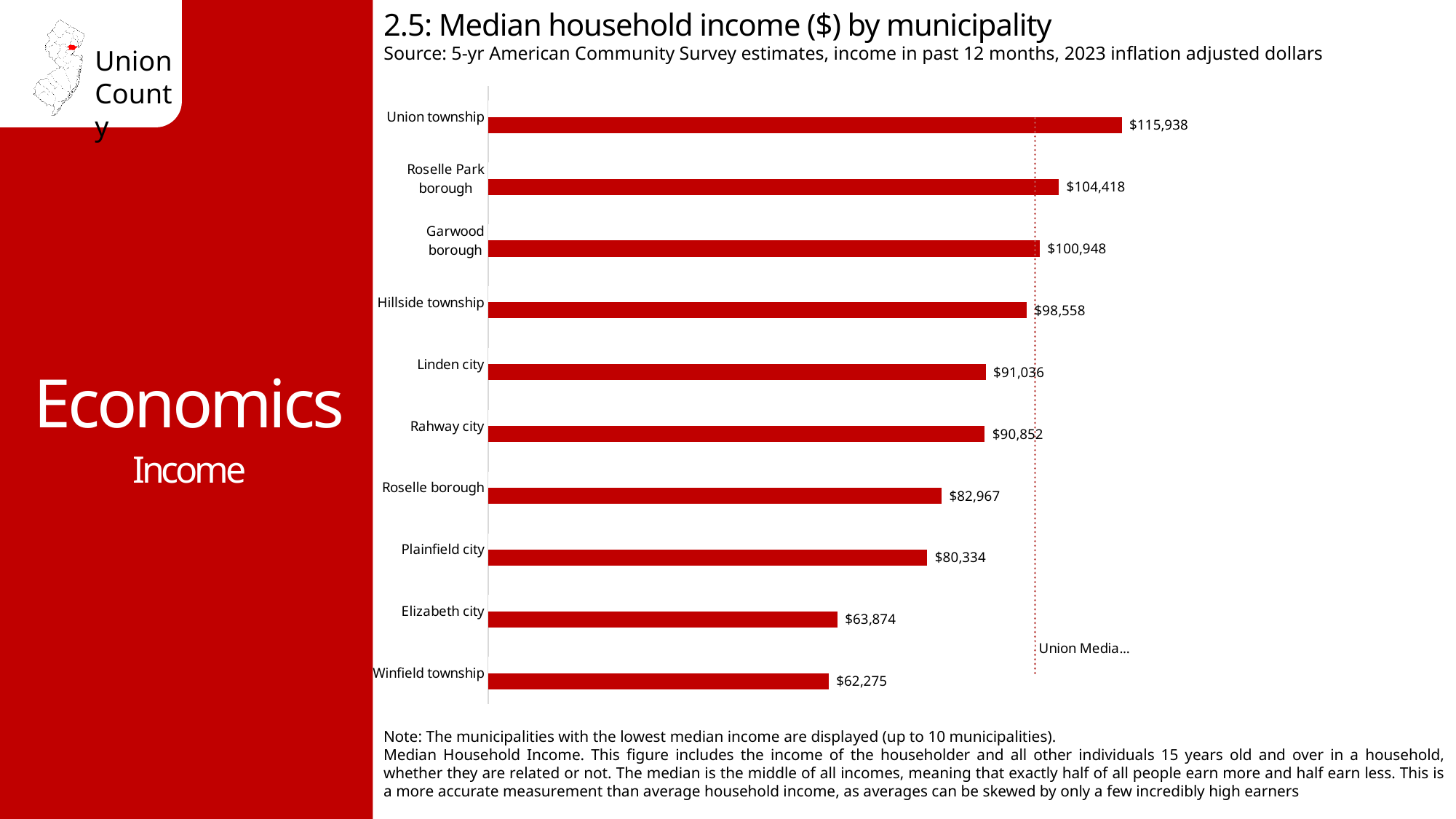
What type of chart is used to show median household income by municipality? Bar chart Which has a higher median household income, Plainfield city or Elizabeth city? Plainfield city What is the difference in median household income between Union township and Winfield township? $53,663 Which municipality has the highest median household income on the chart? Union township What is the median household income for Hillside township? $98,558 What is the median household income for Elizabeth city? $63,874 How many municipalities are shown on the chart? 10 Which municipality has the lowest median household income on the chart? Winfield township What is the title of the chart? 2.5: Median household income ($) by municipality What is the median household income for Union township? $115,938 What is the median household income for Roselle borough? $82,967 What is the difference in median household income between Roselle Park borough and Garwood borough? $3,470